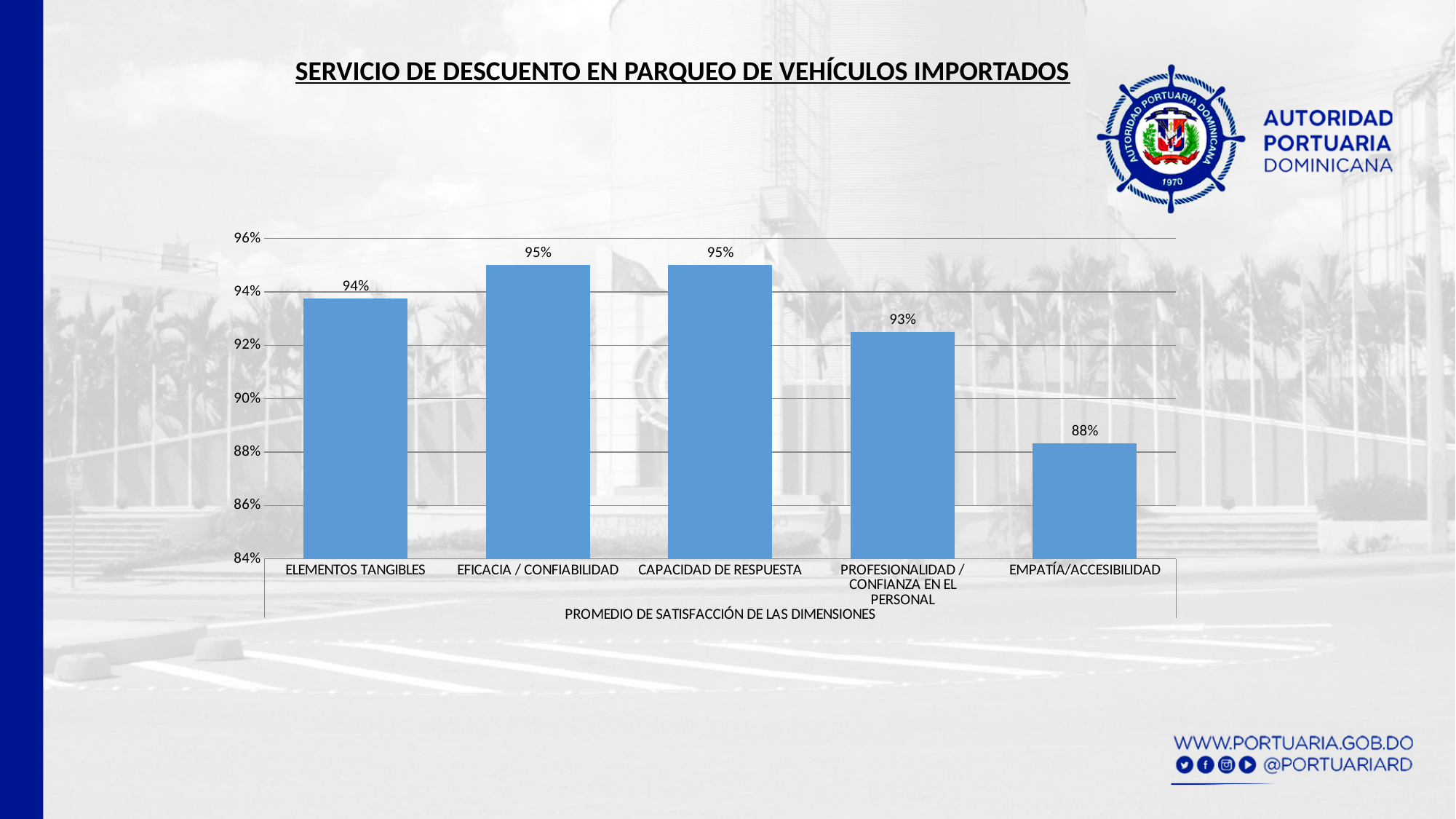
What is the value for EFICACIA / CONFIABILIDAD? 95% Is the value for EMPATÍA/ACCESIBILIDAD greater or less than 90%? less Which category has the lowest value? EMPATÍA/ACCESIBILIDAD What is the value for ELEMENTOS TANGIBLES? 94% What is the title of the chart? SERVICIO DE DESCUENTO EN PARQUEO DE VEHÍCULOS IMPORTADOS Which is larger, the value for EFICACIA / CONFIABILIDAD or the value for PROFESIONALIDAD / CONFIANZA EN EL PERSONAL? EFICACIA / CONFIABILIDAD What kind of chart is shown on the slide? bar chart What is the value for PROFESIONALIDAD / CONFIANZA EN EL PERSONAL? 93% What is the difference between the values for ELEMENTOS TANGIBLES and PROFESIONALIDAD / CONFIANZA EN EL PERSONAL? 1 percentage point How many categories are shown on the x axis? 5 What is the value for EMPATÍA/ACCESIBILIDAD? 88% What is the difference between the values for CAPACIDAD DE RESPUESTA and EMPATÍA/ACCESIBILIDAD? 7 percentage points